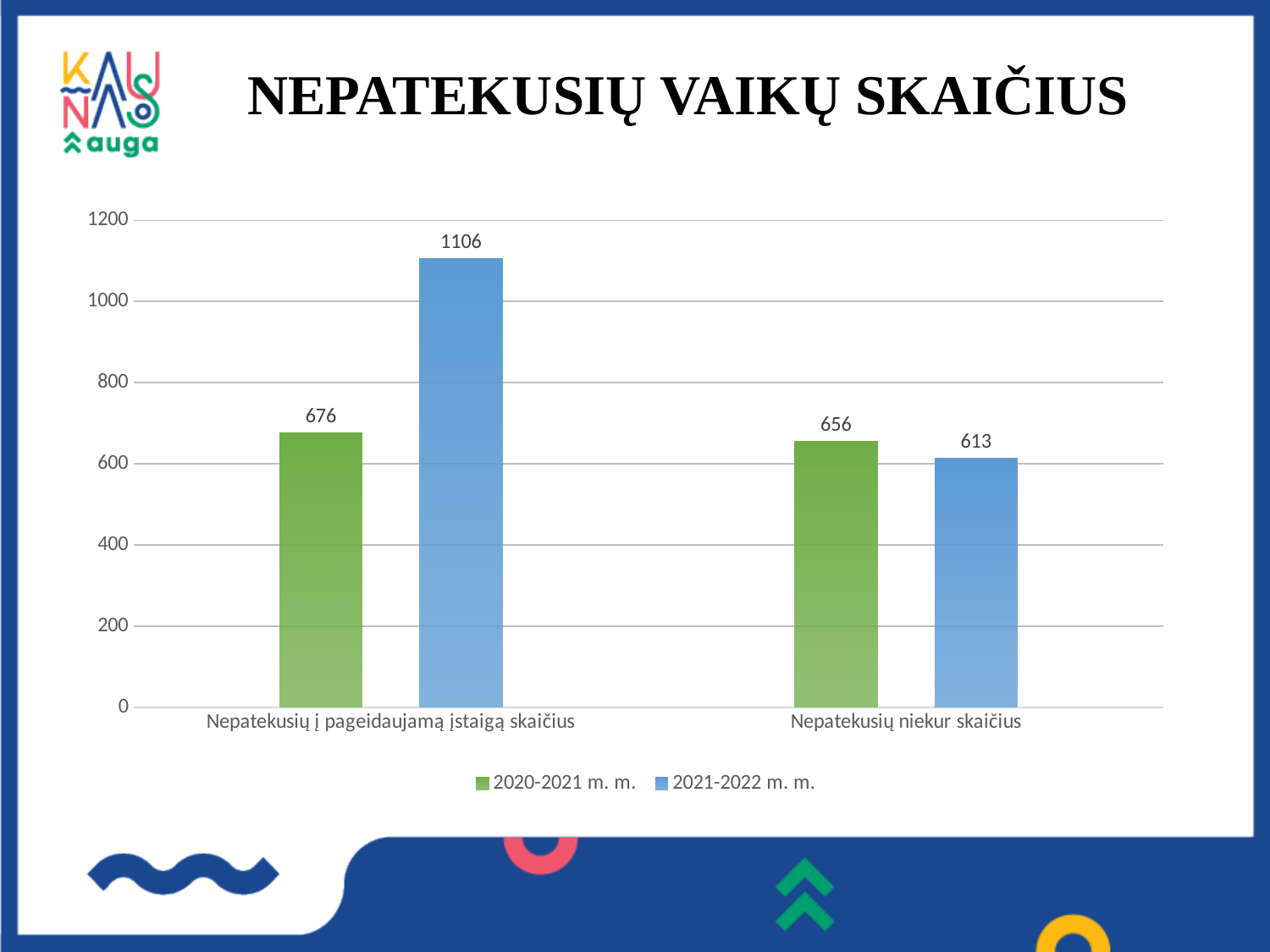
Which bar has the highest value on the chart? 2021-2022 m. m., Nepatekusių į pageidaujamą įstaigą skaičius What is the value for 2021-2022 m. m. in the category "Nepatekusių niekur skaičius"? 613 Which bar has the lowest value on the chart? 2021-2022 m. m., Nepatekusių niekur skaičius What is the difference between the 2020-2021 m. m. and 2021-2022 m. m. values for "Nepatekusių niekur skaičius"? 43 What is the value for 2020-2021 m. m. in the category "Nepatekusių niekur skaičius"? 656 For "Nepatekusių niekur skaičius", which series has the larger value: 2020-2021 m. m. or 2021-2022 m. m.? 2020-2021 m. m. What is the difference between the 2021-2022 m. m. and 2020-2021 m. m. values for "Nepatekusių į pageidaujamą įstaigą skaičius"? 430 How many series does the legend list? 2 What is the value for 2021-2022 m. m. in the category "Nepatekusių į pageidaujamą įstaigą skaičius"? 1106 How many categories are shown on the x axis? 2 What kind of chart is shown on the slide? Bar chart What is the value for 2020-2021 m. m. in the category "Nepatekusių į pageidaujamą įstaigą skaičius"? 676